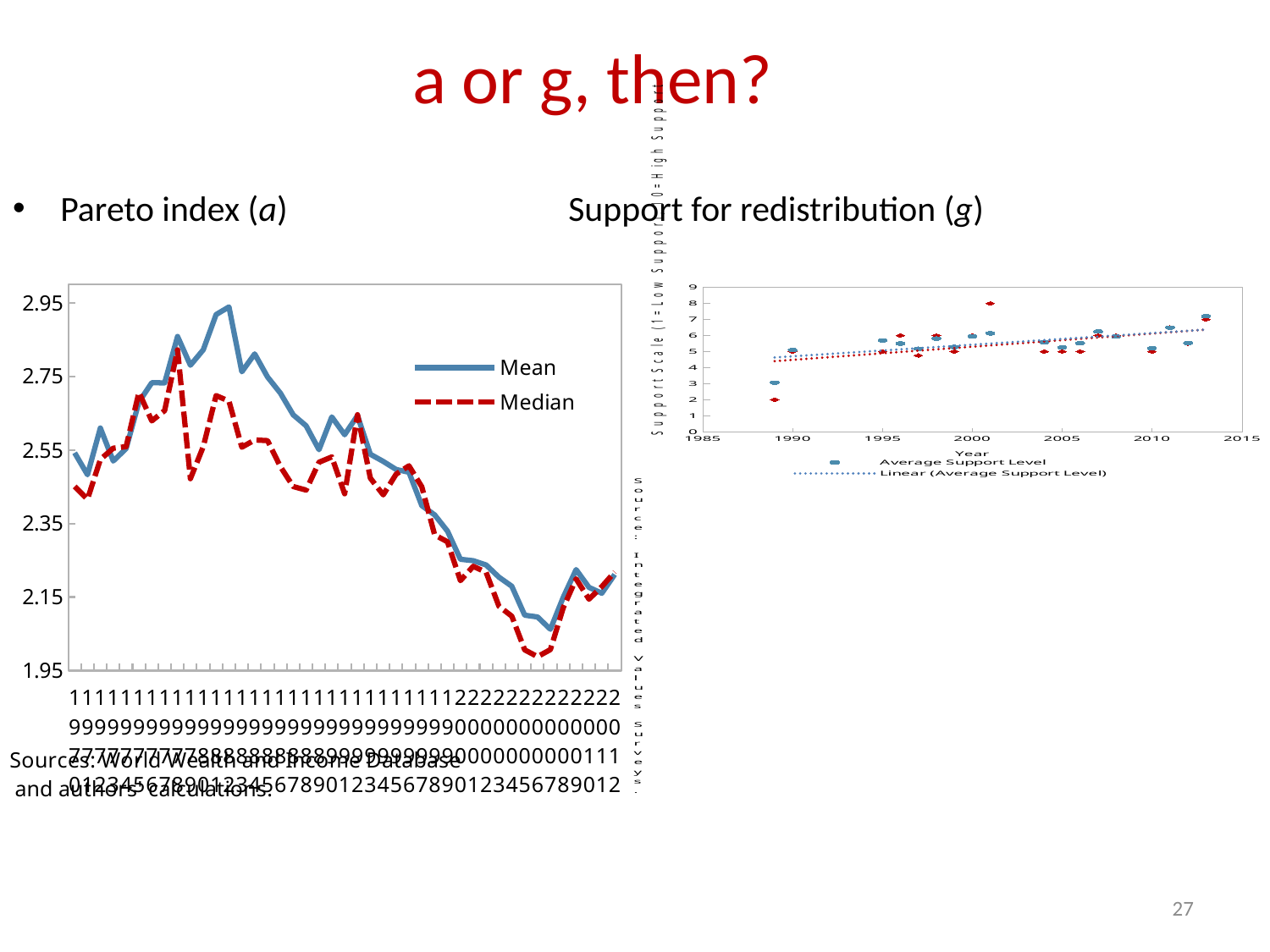
On the right Support for redistribution chart, which year has the lowest Average Support Level? 1989 On the left Pareto index chart, which series is higher in 1978, Mean or Median? Mean On the right Support for redistribution chart, is the Average Support Level for 1989 greater or less than 4? less On the right Support for redistribution chart, does the linear trend line rise or fall from 1985 to 2015? rise What kind of chart is the Support for redistribution chart on the right of the slide? scatter chart What are the two series named in the legend of the left Pareto index chart? Mean and Median How many series does the legend of the left Pareto index chart list? 2 What are the two entries in the legend of the right Support for redistribution chart? Average Support Level and Linear (Average Support Level) On the left Pareto index chart, does the Mean line end in 2012 higher or lower than it starts in 1970? lower On the left Pareto index chart, is the Mean value for 1978 greater or less than 2.75? greater What kind of chart is the Pareto index chart on the left of the slide? line chart On the left Pareto index chart, is the Median value for 2005 greater or less than 2.15? less